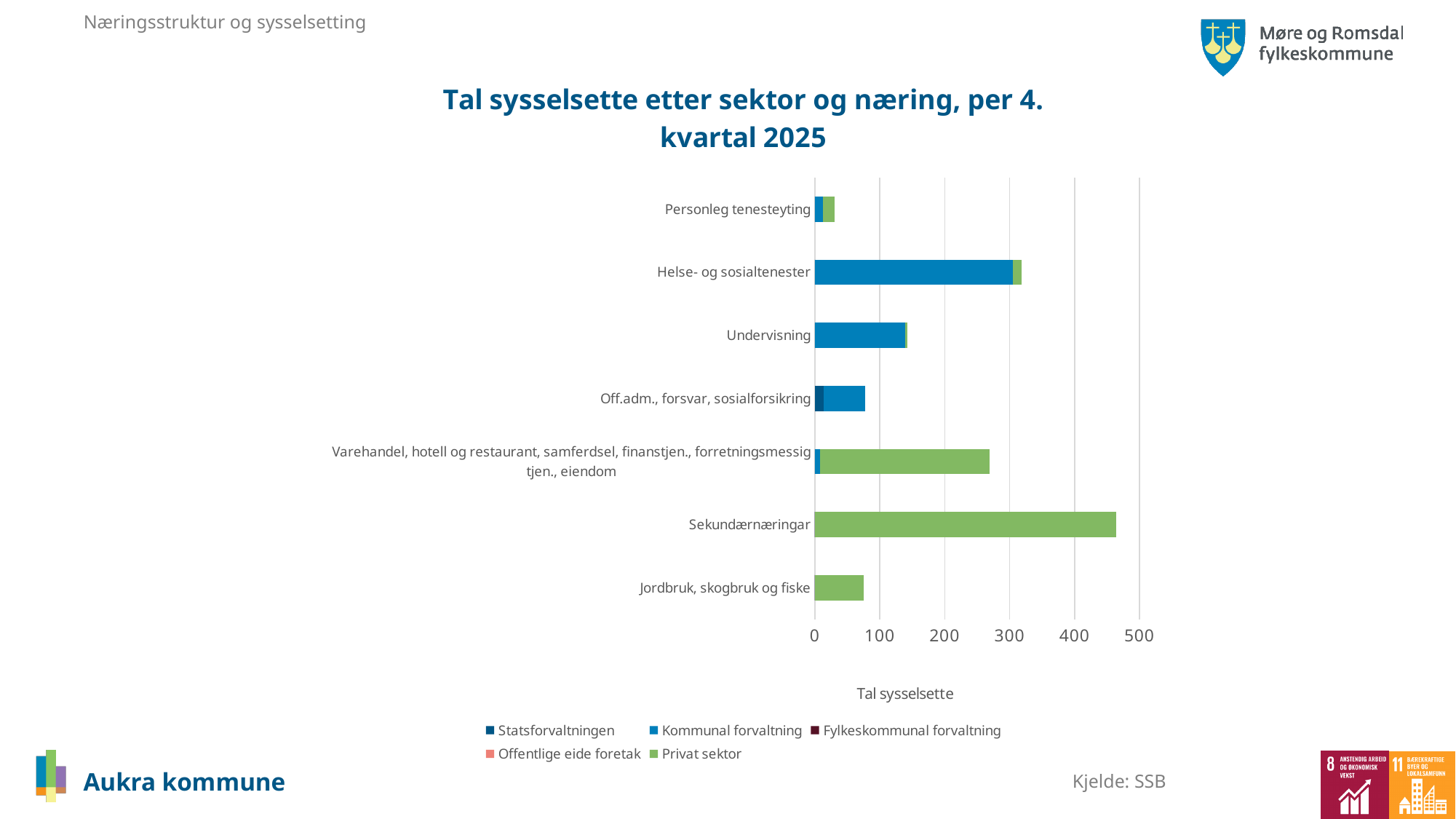
How many categories (næringar) are shown on the vertical axis of the chart? 7 Is the total value for Varehandel, hotell og restaurant, samferdsel, finanstjen., forretningsmessig tjen., eiendom greater or less than 300? less Which has the larger total bar: Sekundærnæringar or Helse- og sosialtenester? Sekundærnæringar Is the total value for Sekundærnæringar greater or less than 400? greater What is the label on the horizontal axis of the chart? Tal sysselsette What is the title of the chart? Tal sysselsette etter sektor og næring, per 4. kvartal 2025 Which category has the shortest total bar? Personleg tenesteyting Which category has the longest total bar? Sekundærnæringar How many series does the legend list? 5 What kind of chart is shown on the slide? Bar chart Is the total value for Undervisning greater or less than 100? greater